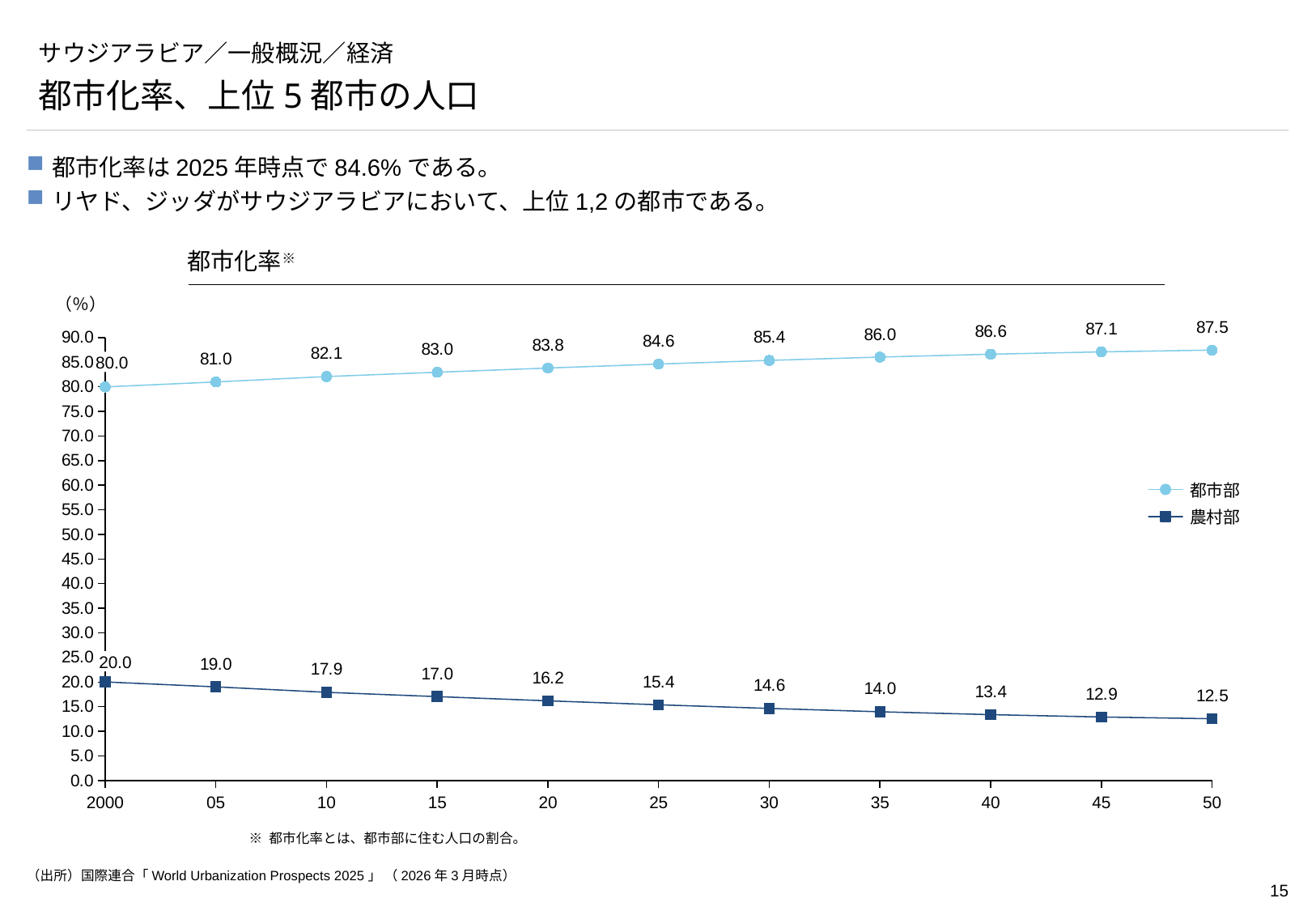
What is the value for 農村部 in 2050? 12.5 In which year is the 農村部 value lowest? 2050 How many data points does each series have? 11 Which is larger, the 農村部 value in 2005 or in 2045? 2005 How many series does the legend list? 2 What is the value for 都市部 in 2010? 82.1 What is the value for 都市部 in 2025? 84.6 What kind of chart is shown? Line chart What is the difference between the 都市部 value in 2050 and in 2000? 7.5 In which year is the 都市部 value highest? 2050 Does the 農村部 series rise or fall from 2000 to 2050? Fall What is the value for 農村部 in 2000? 20.0